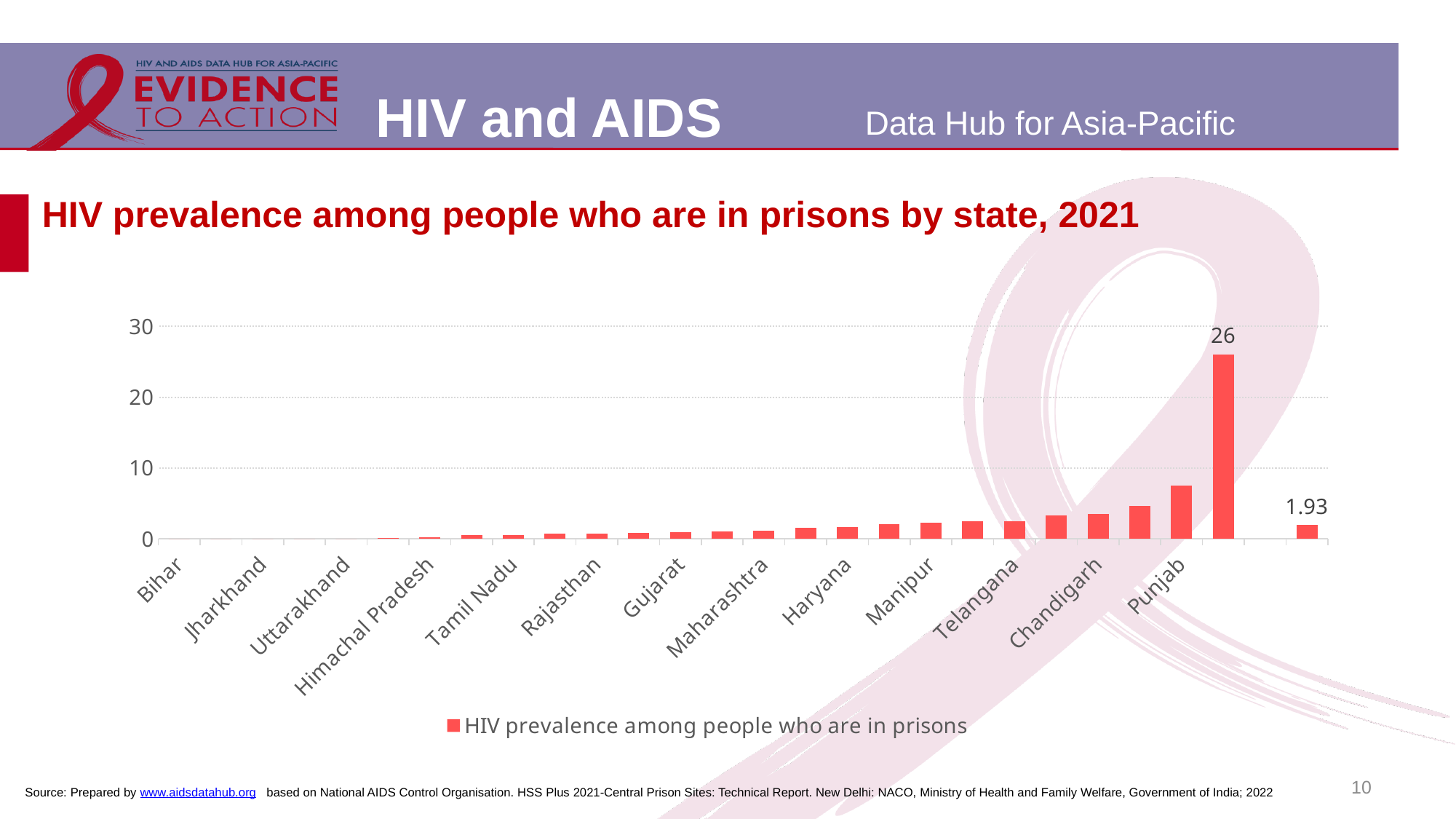
Is the value for Bihar greater or less than 10? less Do the bar values generally rise or fall from Bihar on the left to Punjab on the right? rise Which is larger, the value for Punjab or the value for Chandigarh? Punjab What is the legend entry for the series shown? HIV prevalence among people who are in prisons Is the value for Chandigarh greater or less than 10? less How many series does the legend list? 1 What kind of chart is shown on the slide? bar chart What is the value printed on the last bar at the right end of the chart? 1.93 What is the highest value shown on the chart? 26 What is the title of the chart? HIV prevalence among people who are in prisons by state, 2021 Is the value for Punjab greater or less than 10? less Which is larger, the value for Punjab or the value for Bihar? Punjab